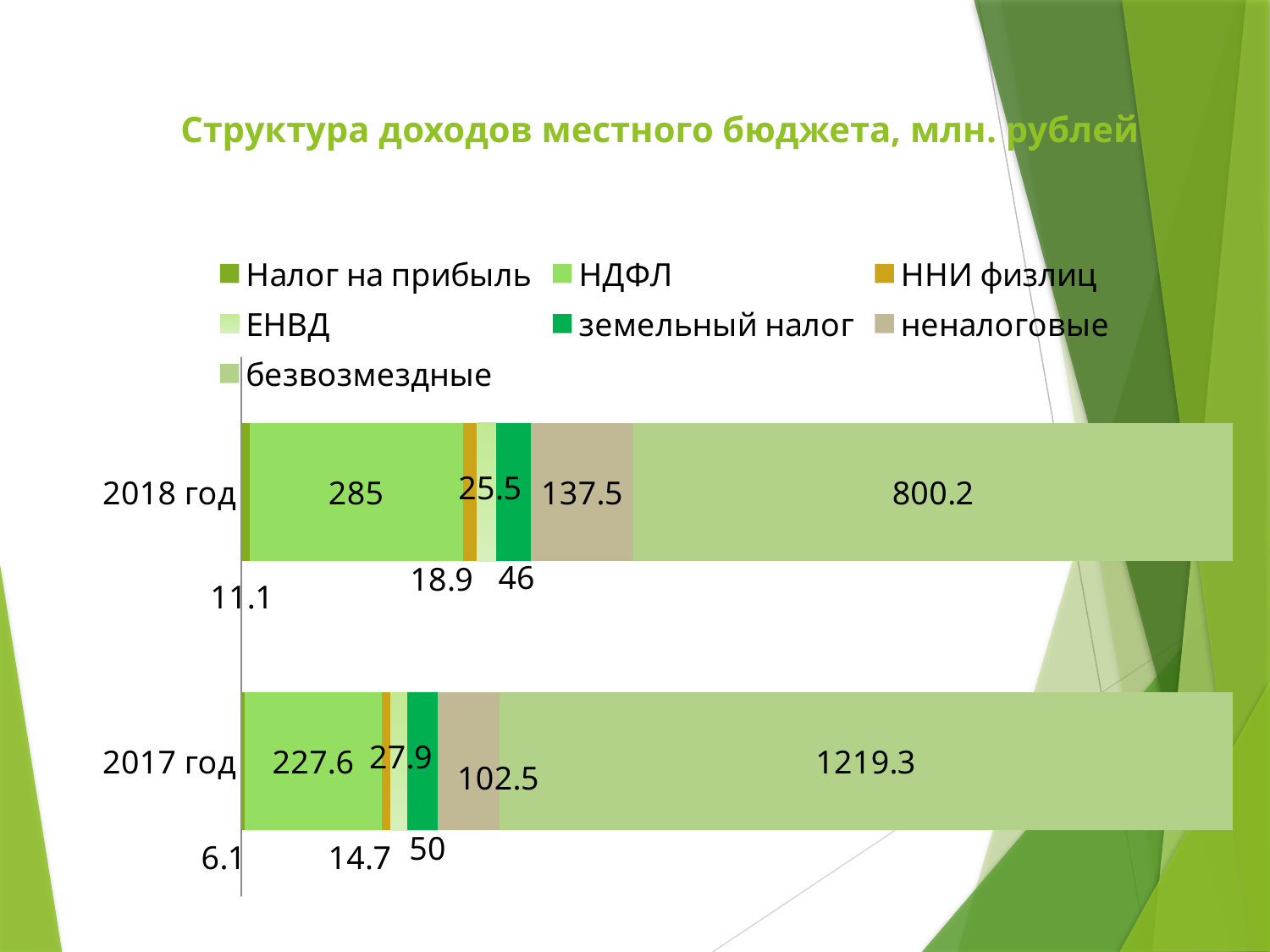
Which series has the smallest value in the 2018 год bar? Налог на прибыль Which year has the larger value for безвозмездные, 2018 год or 2017 год? 2017 год What is the value of безвозмездные for 2018 год? 800.2 What is the value of Налог на прибыль for 2017 год? 6.1 What is the total of the 2018 год stacked bar? 1324.2 What type of chart is shown on the slide? Stacked bar chart What is the value of земельный налог for 2018 год? 46 What is the difference between the НДФЛ values for 2018 год and 2017 год? 57.4 What is the value of неналоговые for 2018 год? 137.5 Which series has the largest value in the 2017 год bar? безвозмездные How many series does the legend list? 7 What is the value of НДФЛ for 2017 год? 227.6